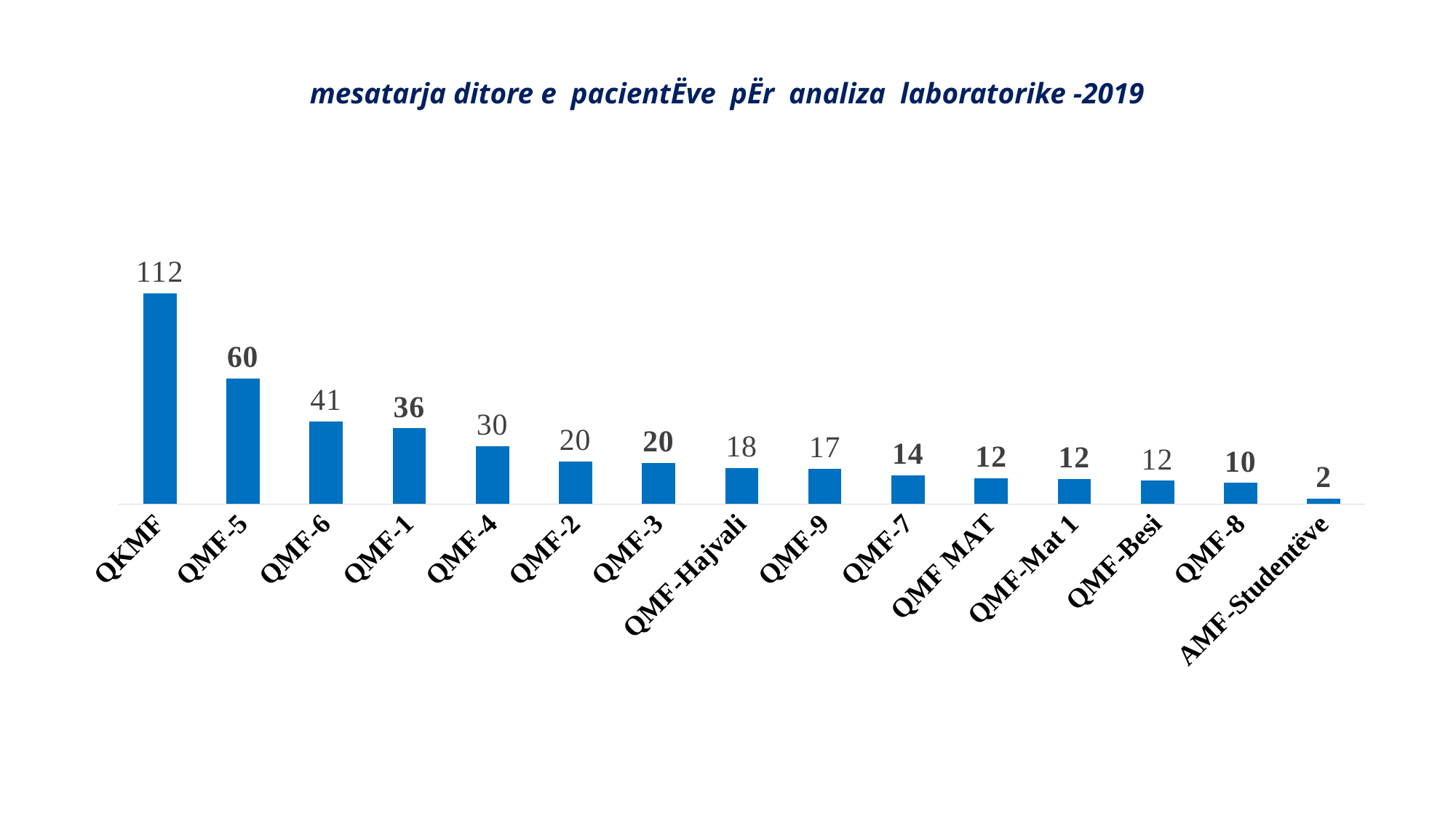
Which category has the highest value? QKMF How many categories are shown on the x axis? 15 Which is larger, the value for QMF-4 or the value for QMF-9? QMF-4 Do the values rise or fall from left to right along the x axis? fall What is the value for QKMF? 112 What is the difference between the values for QMF-6 and QMF-1? 5 What is the difference between the values for QKMF and QMF-5? 52 What is the title of the chart? mesatarja ditore e pacientËve pËr analiza laboratorike -2019 What kind of chart is shown on the slide? bar chart What is the value for AMF-Studentëve? 2 Which category has the lowest value? AMF-Studentëve What is the value for QMF-Hajvali? 18